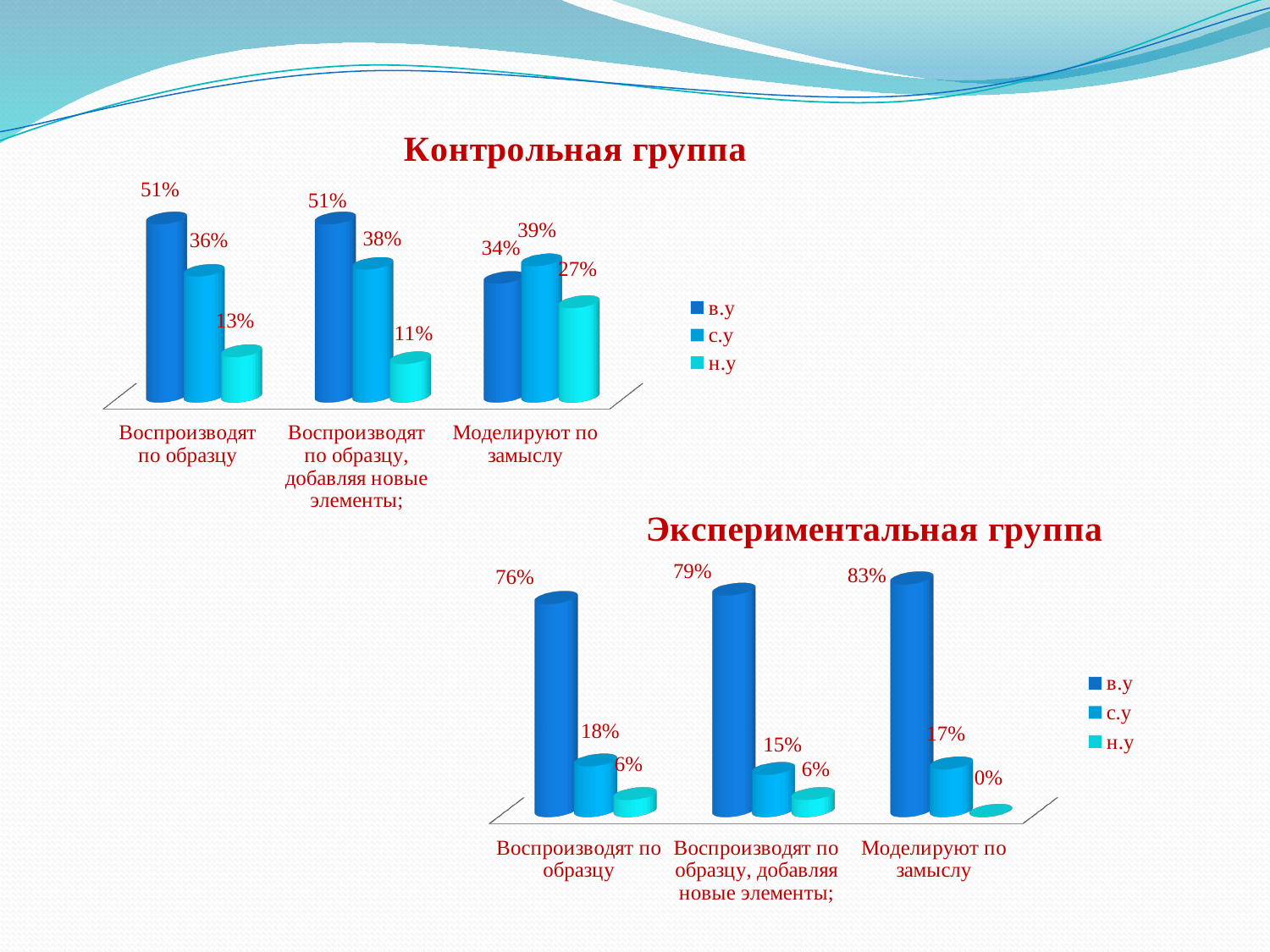
What kind of chart is the 'Экспериментальная группа' chart? Bar chart How many categories are shown on the x axis of the 'Контрольная группа' chart? 3 In the 'Контрольная группа' chart, which category has the lowest н.у value? Воспроизводят по образцу, добавляя новые элементы In the 'Контрольная группа' chart, what is the difference between the в.у and с.у values for 'Воспроизводят по образцу'? 15% In the 'Экспериментальная группа' chart, what is the value of в.у for 'Моделируют по замыслу'? 83% How many series does the legend of the 'Экспериментальная группа' chart list? 3 In the 'Экспериментальная группа' chart, which category has the highest в.у value? Моделируют по замыслу In the 'Контрольная группа' chart, what is the value of в.у for 'Воспроизводят по образцу'? 51% In the 'Контрольная группа' chart, for 'Моделируют по замыслу', which is larger: в.у or с.у? с.у In the 'Экспериментальная группа' chart, what is the difference between the в.у values for 'Моделируют по замыслу' and 'Воспроизводят по образцу'? 7% In the 'Экспериментальная группа' chart, what is the value of с.у for 'Воспроизводят по образцу, добавляя новые элементы'? 15% In the 'Контрольная группа' chart, what is the value of н.у for 'Моделируют по замыслу'? 27%